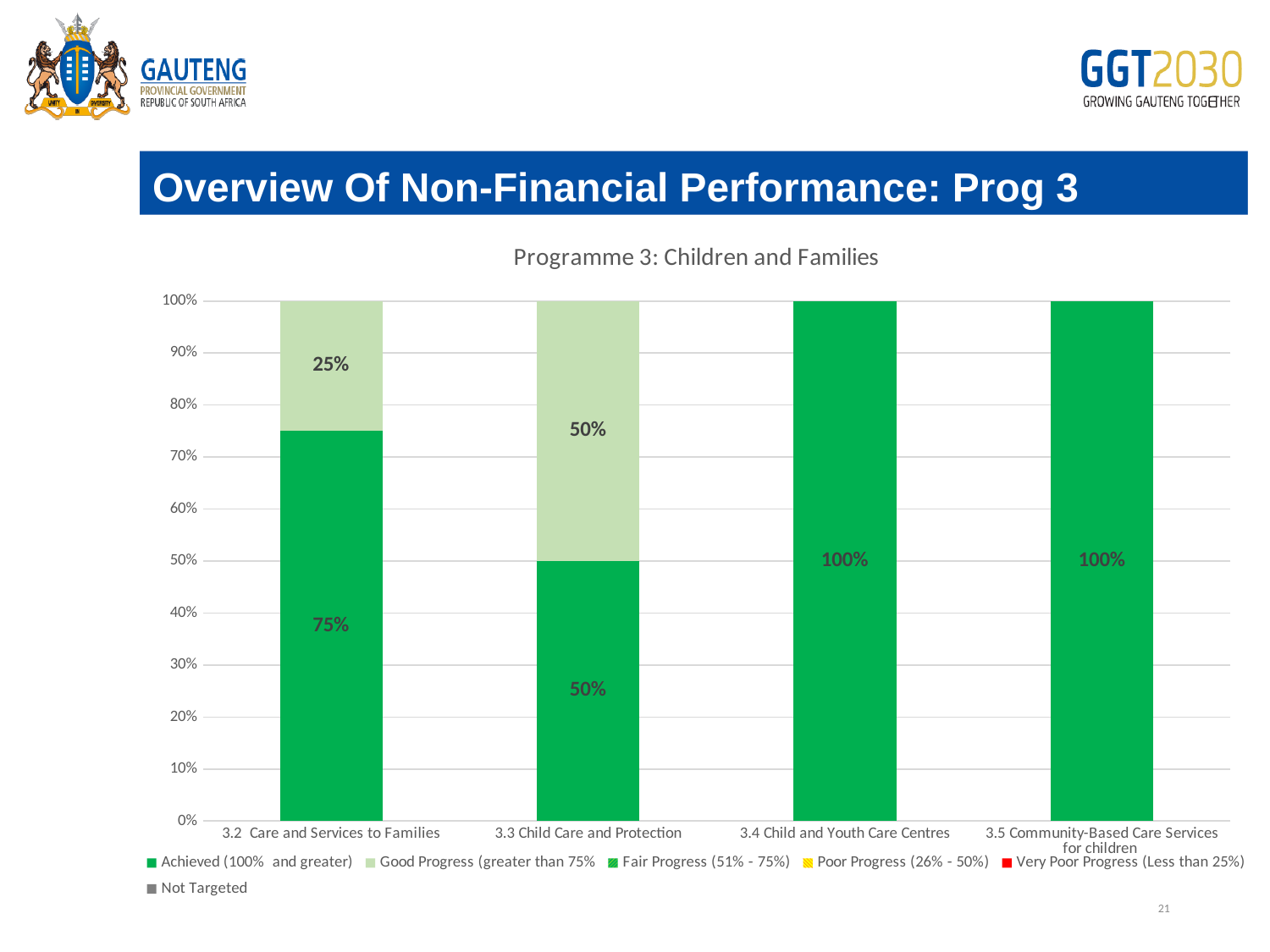
What is the Achieved (100% and greater) value for 3.2 Care and Services to Families? 75% Which category has the lowest Achieved (100% and greater) value? 3.3 Child Care and Protection What is the Good Progress (greater than 75%) value for 3.2 Care and Services to Families? 25% What type of chart is shown on the slide? Stacked bar chart What is the Achieved (100% and greater) value for 3.4 Child and Youth Care Centres? 100% Which is larger: the Achieved value for 3.2 Care and Services to Families or the Achieved value for 3.3 Child Care and Protection? 3.2 Care and Services to Families What is the difference between the Achieved value for 3.2 Care and Services to Families and the Achieved value for 3.3 Child Care and Protection? 25% How many categories are shown on the x axis of the chart? 4 What is the title of the chart? Programme 3: Children and Families How many series does the chart's legend list? 6 What is the total of the stacked bar for 3.3 Child Care and Protection? 100% What is the Achieved (100% and greater) value for 3.3 Child Care and Protection? 50%